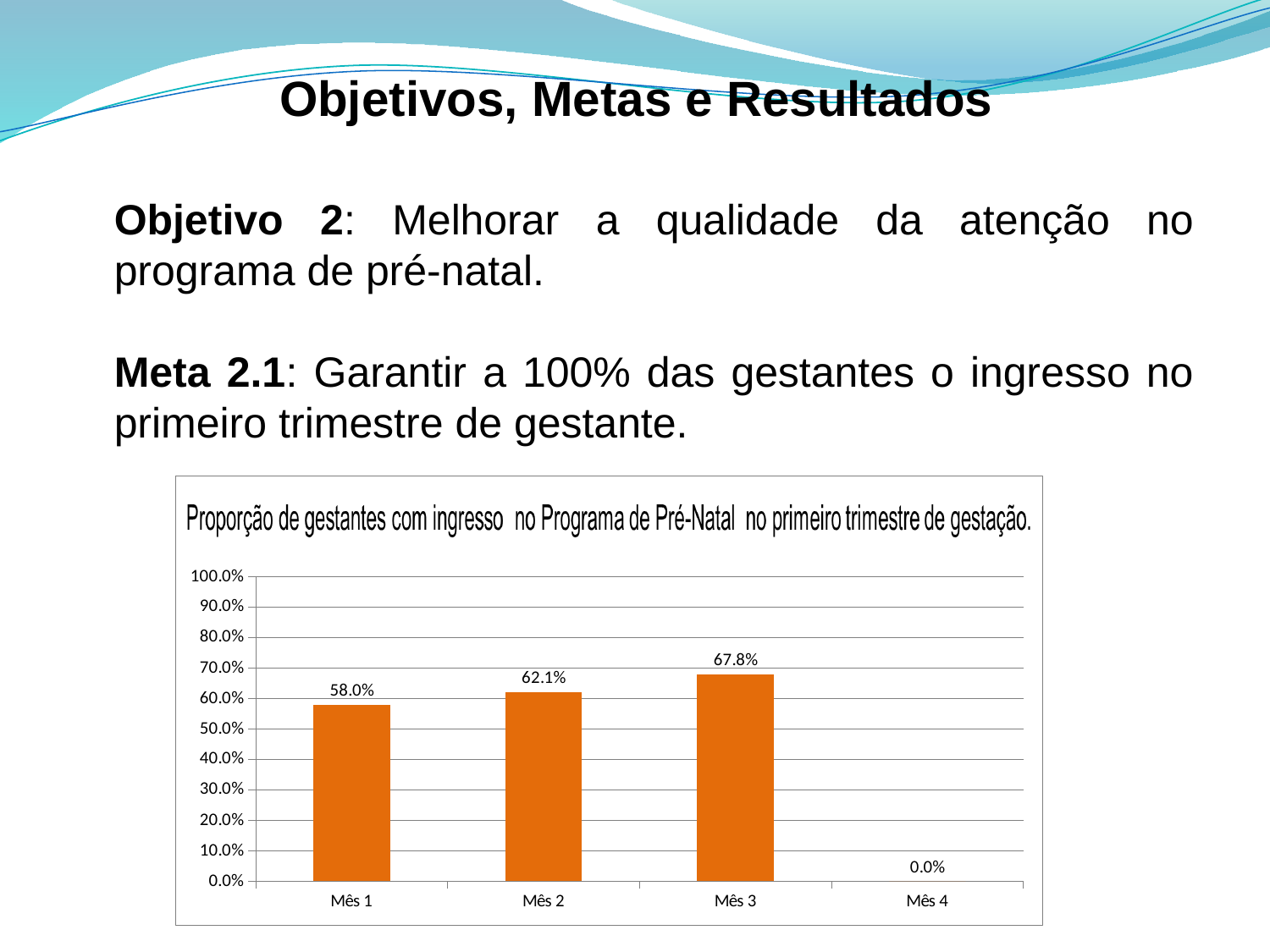
What is the value for Mês 4? 0.0% Which month has the lowest value? Mês 4 What is the value for Mês 1? 58.0% What is the title of the chart? Proporção de gestantes com ingresso no Programa de Pré-Natal no primeiro trimestre de gestação. What is the value for Mês 3? 67.8% Is the value for Mês 3 greater or less than 60.0%? greater How many months are shown on the x axis? 4 Which month has the highest value? Mês 3 What is the difference between the values for Mês 3 and Mês 1? 9.8% What kind of chart is shown? bar chart Which is larger, the value for Mês 2 or the value for Mês 1? Mês 2 What is the value for Mês 2? 62.1%